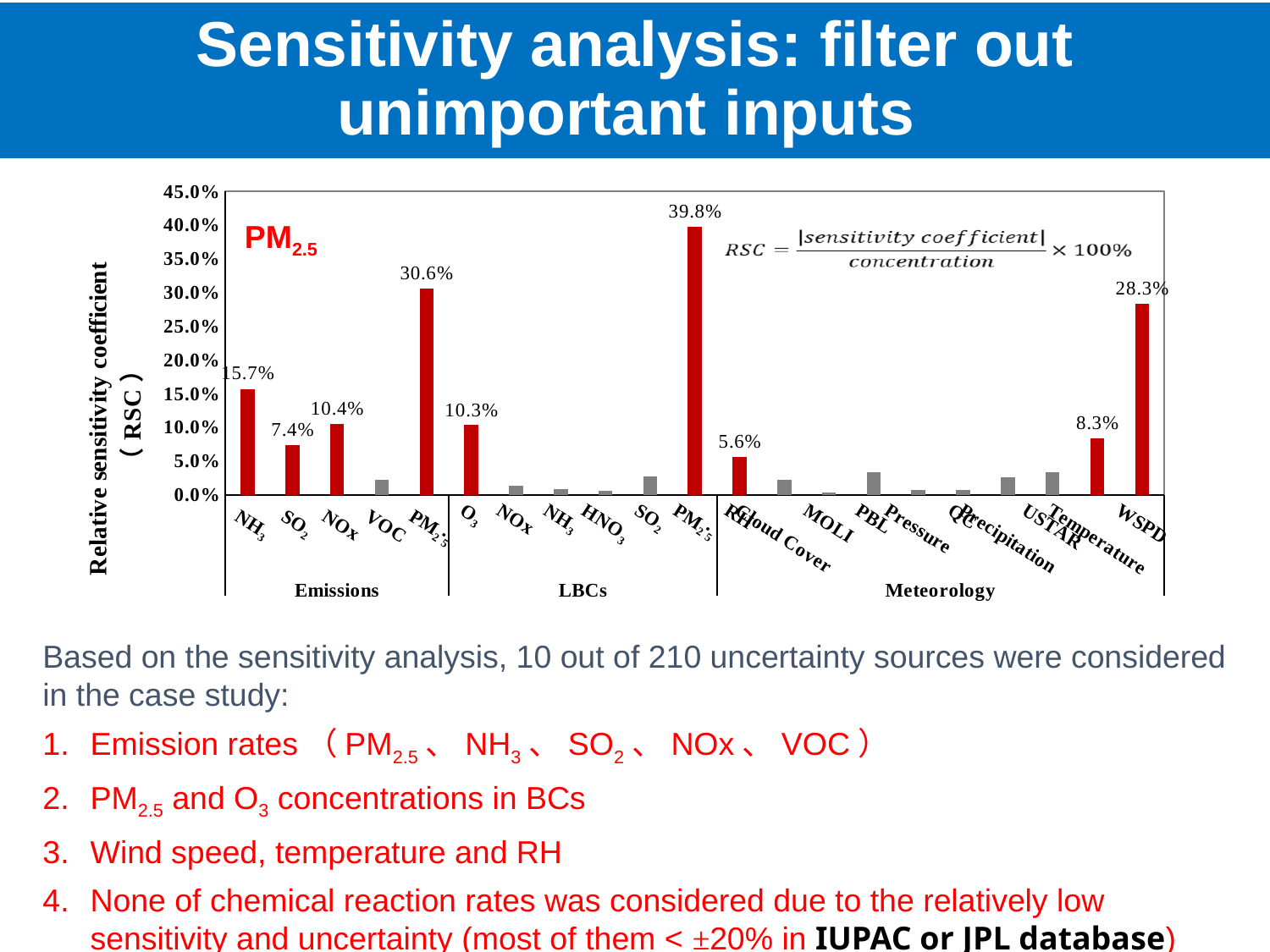
What is the difference between the RSC of PM2.5 in LBCs and PM2.5 in Emissions? 9.2% What is the label of the vertical axis of the chart? Relative sensitivity coefficient (RSC) What is the relative sensitivity coefficient for PM2.5 in the LBCs group? 39.8% How many inputs are shown in the Emissions group? 5 What kind of chart is shown on the slide? bar chart What is the difference between the RSC of NH3 and SO2 in the Emissions group? 8.3% Which input has the highest relative sensitivity coefficient in the chart? PM2.5 (LBCs) Is the RSC value for VOC in the Emissions group greater or less than 5.0%? less What is the relative sensitivity coefficient for WSPD? 28.3% Which has a larger RSC in the Emissions group, NH3 or NOx? NH3 What is the relative sensitivity coefficient for RH in the Meteorology group? 5.6% What is the relative sensitivity coefficient for PM2.5 in the Emissions group? 30.6%